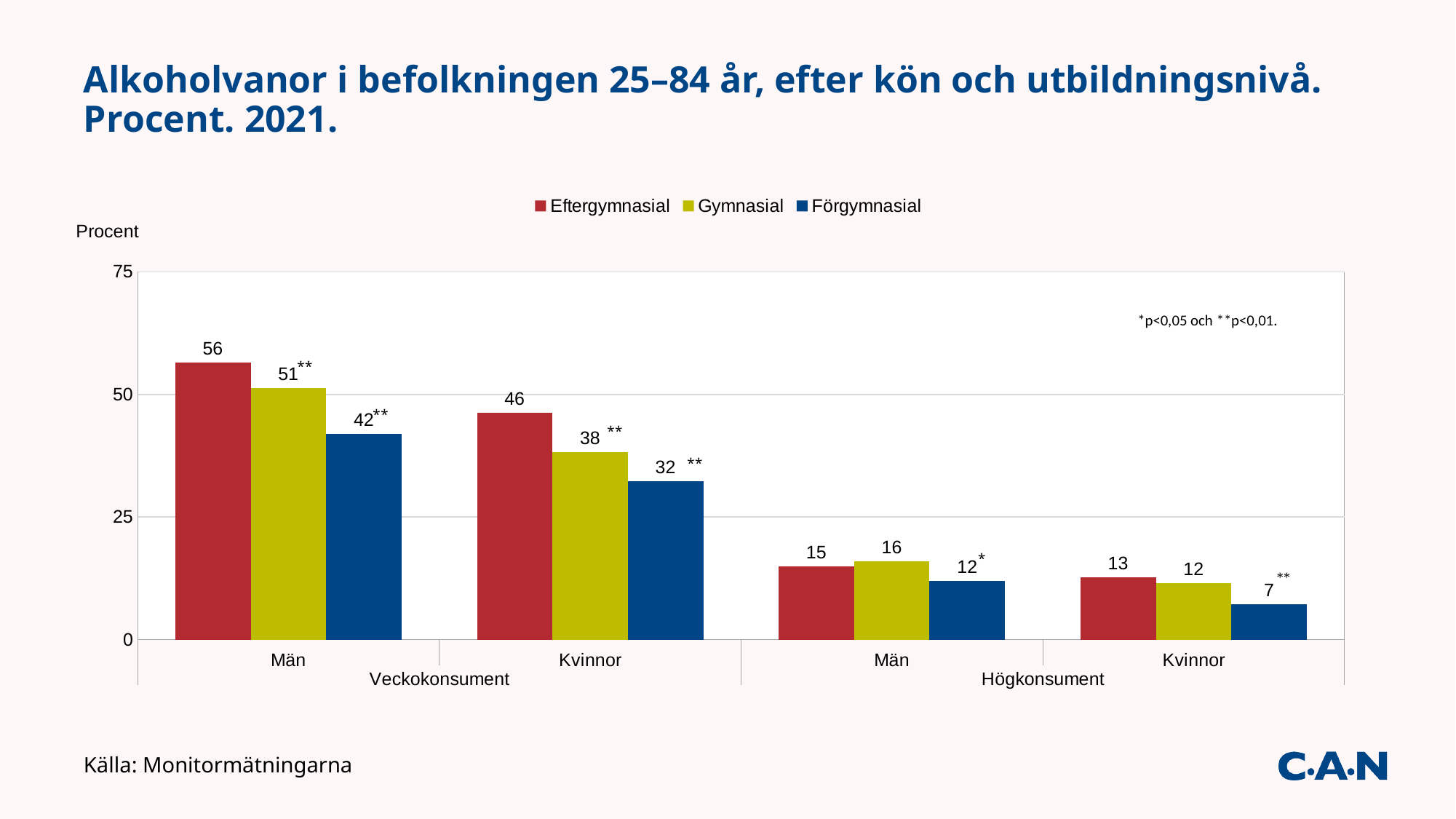
What is the difference between the Eftergymnasial and Förgymnasial values among Kvinnor in the Veckokonsument group? 14 Is the value for Förgymnasial among Män in the Veckokonsument group greater or less than 50? less What kind of chart is shown on the slide? bar chart What is the source given for the chart? Monitormätningarna What is the value for Gymnasial among Kvinnor in the Veckokonsument group? 38 What is the value for Förgymnasial among Kvinnor in the Högkonsument group? 7 Which series has the lowest value among Kvinnor in the Högkonsument group? Förgymnasial Which colour represents Förgymnasial in the chart? blue How many series does the legend list? 3 Among Män in the Högkonsument group, which is larger: Eftergymnasial or Gymnasial? Gymnasial Which series has the highest value among Män in the Veckokonsument group? Eftergymnasial What is the value for Eftergymnasial among Män in the Veckokonsument group? 56